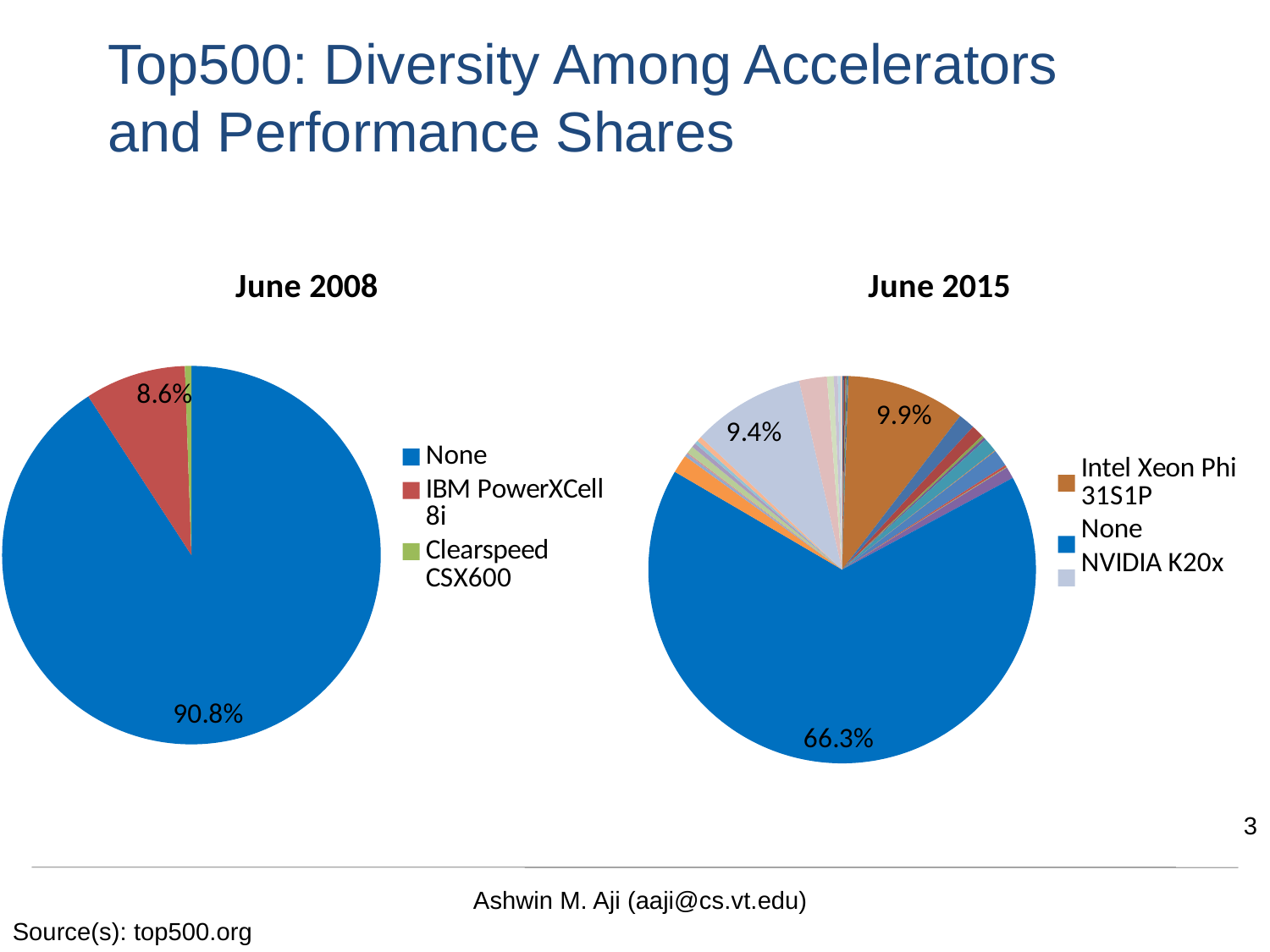
In the June 2015 pie chart, which has the larger share, Intel Xeon Phi 31S1P or NVIDIA K20x? Intel Xeon Phi 31S1P In the June 2008 pie chart, what share is labelled for the None slice? 90.8% How many entries does the legend of the June 2008 pie chart list? 3 In the June 2008 pie chart, which category has the smallest slice? Clearspeed CSX600 In the June 2015 pie chart, what share is labelled for the None slice? 66.3% What kind of chart is used for June 2008 and June 2015 on this slide? Pie chart In the June 2008 pie chart, which category has the largest slice? None In the June 2015 pie chart, what share is labelled for NVIDIA K20x? 9.4% In the June 2015 pie chart, what share is labelled for Intel Xeon Phi 31S1P? 9.9% In the June 2008 pie chart, what is the difference in percentage points between the None slice and the IBM PowerXCell 8i slice? 82.2% In the June 2015 pie chart, which category has the largest slice? None In the June 2008 pie chart, what share is labelled for IBM PowerXCell 8i? 8.6%